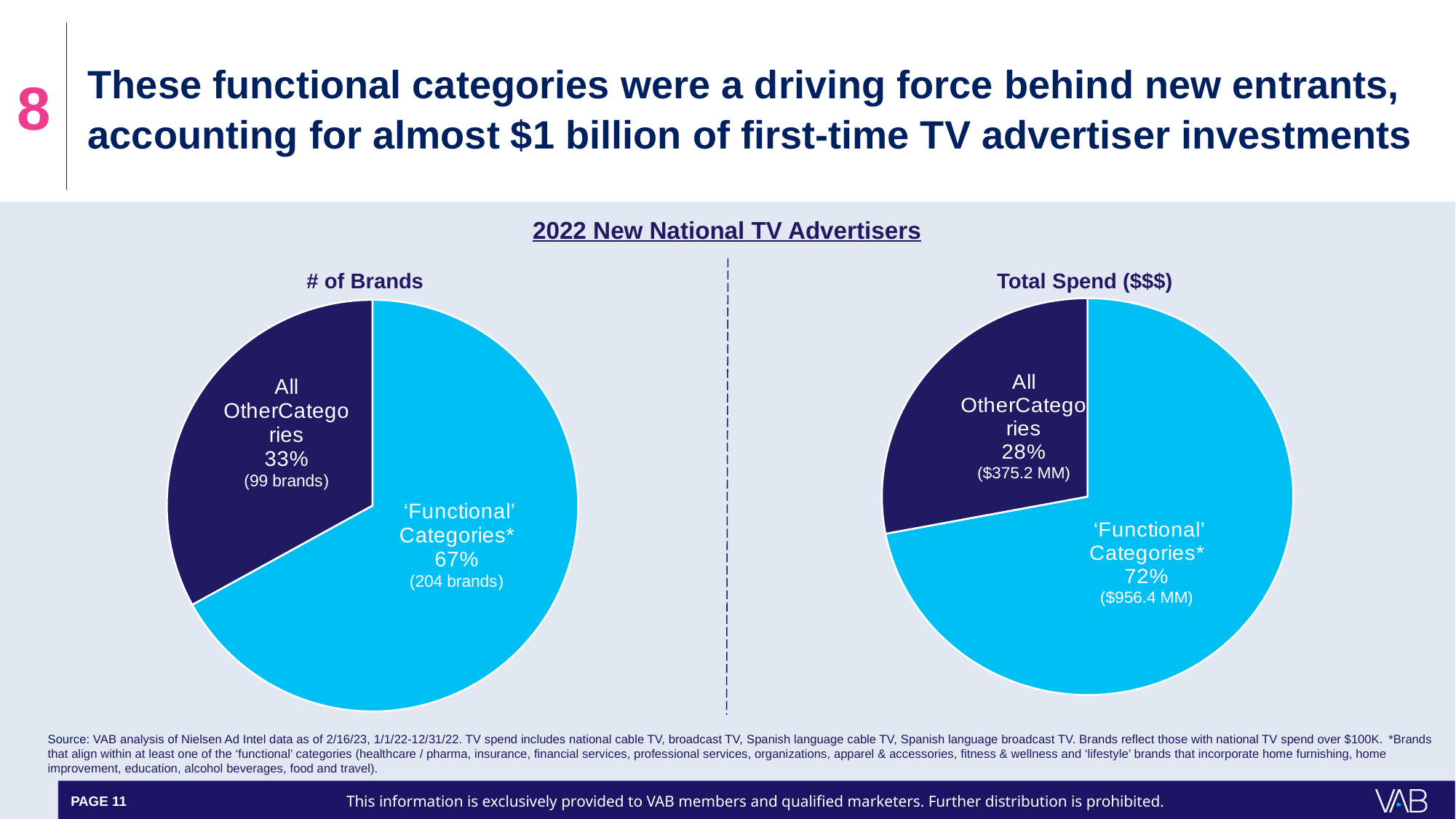
In the 'Total Spend ($$$)' pie chart, what is the spend for All Other Categories? $375.2 MM What is the overall title above the two pie charts? 2022 New National TV Advertisers In the 'Total Spend ($$$)' pie chart, what is the spend for 'Functional' Categories? $956.4 MM What type of chart is used for 'Total Spend ($$$)'? Pie chart How many slices does the '# of Brands' pie chart have? 2 In the 'Total Spend ($$$)' pie chart, what share do 'Functional' Categories account for? 72% In the '# of Brands' pie chart, how many brands are in 'Functional' Categories? 204 brands In the '# of Brands' pie chart, which slice is the largest? 'Functional' Categories In the '# of Brands' pie chart, what is the difference in number of brands between 'Functional' Categories and All Other Categories? 105 brands In the '# of Brands' pie chart, what share do 'Functional' Categories account for? 67% In the '# of Brands' pie chart, how many brands are in All Other Categories? 99 brands In the 'Total Spend ($$$)' pie chart, which slice is the smallest? All Other Categories